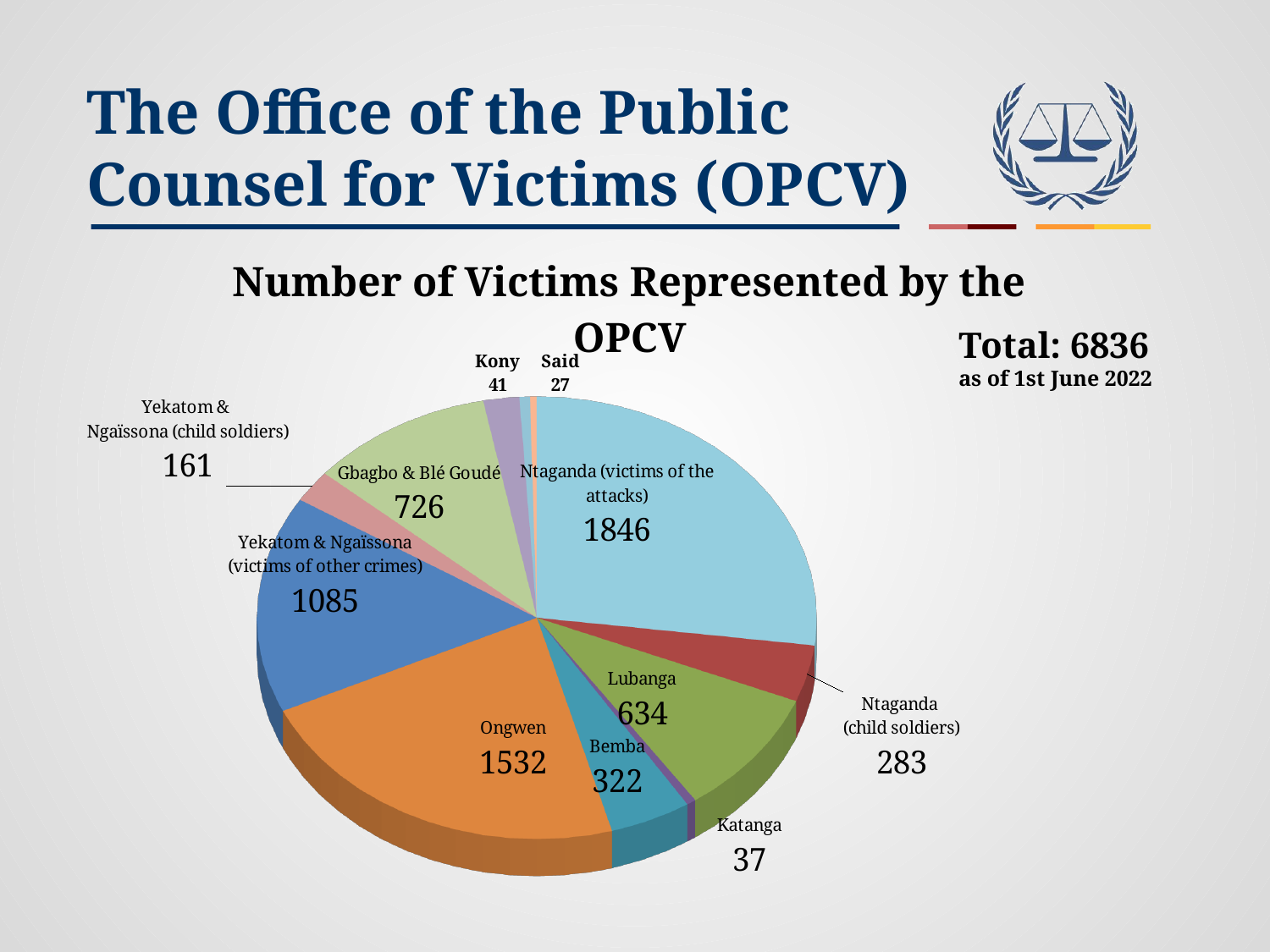
Which case has the largest number of victims represented? Ntaganda (victims of the attacks) How many victims are represented in the Ongwen case? 1532 How many victims are represented in the Lubanga case? 634 What is the title of the chart? Number of Victims Represented by the OPCV What is the number of victims for Ntaganda (victims of the attacks)? 1846 What is the difference between the number of victims for Ongwen and for Yekatom & Ngaïssona (victims of other crimes)? 447 Which has more victims represented, Gbagbo & Blé Goudé or Lubanga? Gbagbo & Blé Goudé How many victims are represented in the Said case? 27 What type of chart is shown on the slide? Pie chart What is the value shown for Yekatom & Ngaïssona (child soldiers)? 161 Which case has the smallest number of victims represented? Said What is the total number of victims stated on the slide? 6836